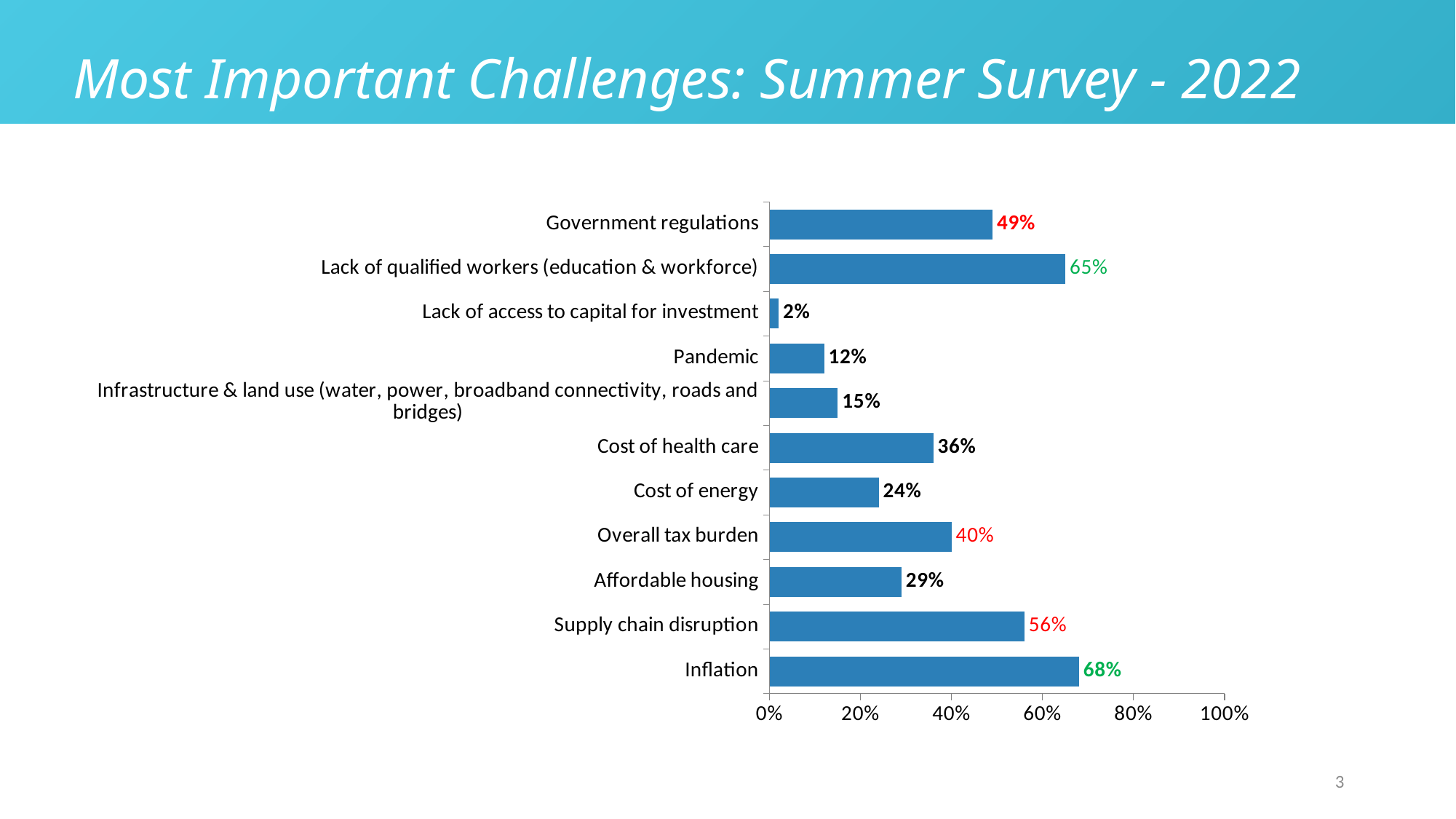
What is the difference between the values for Supply chain disruption and Overall tax burden? 16% What is the value for Cost of health care? 36% Which challenge has the highest value? Inflation What is the value for Lack of qualified workers (education & workforce)? 65% What kind of chart is shown on the slide? bar chart How many challenges are shown in the chart? 11 What is the title of the slide? Most Important Challenges: Summer Survey - 2022 Which is larger, the value for Government regulations or the value for Cost of energy? Government regulations Is the value for Pandemic greater or less than 20%? less What is the value for Affordable housing? 29% What is the value for Inflation? 68% Which challenge has the lowest value? Lack of access to capital for investment